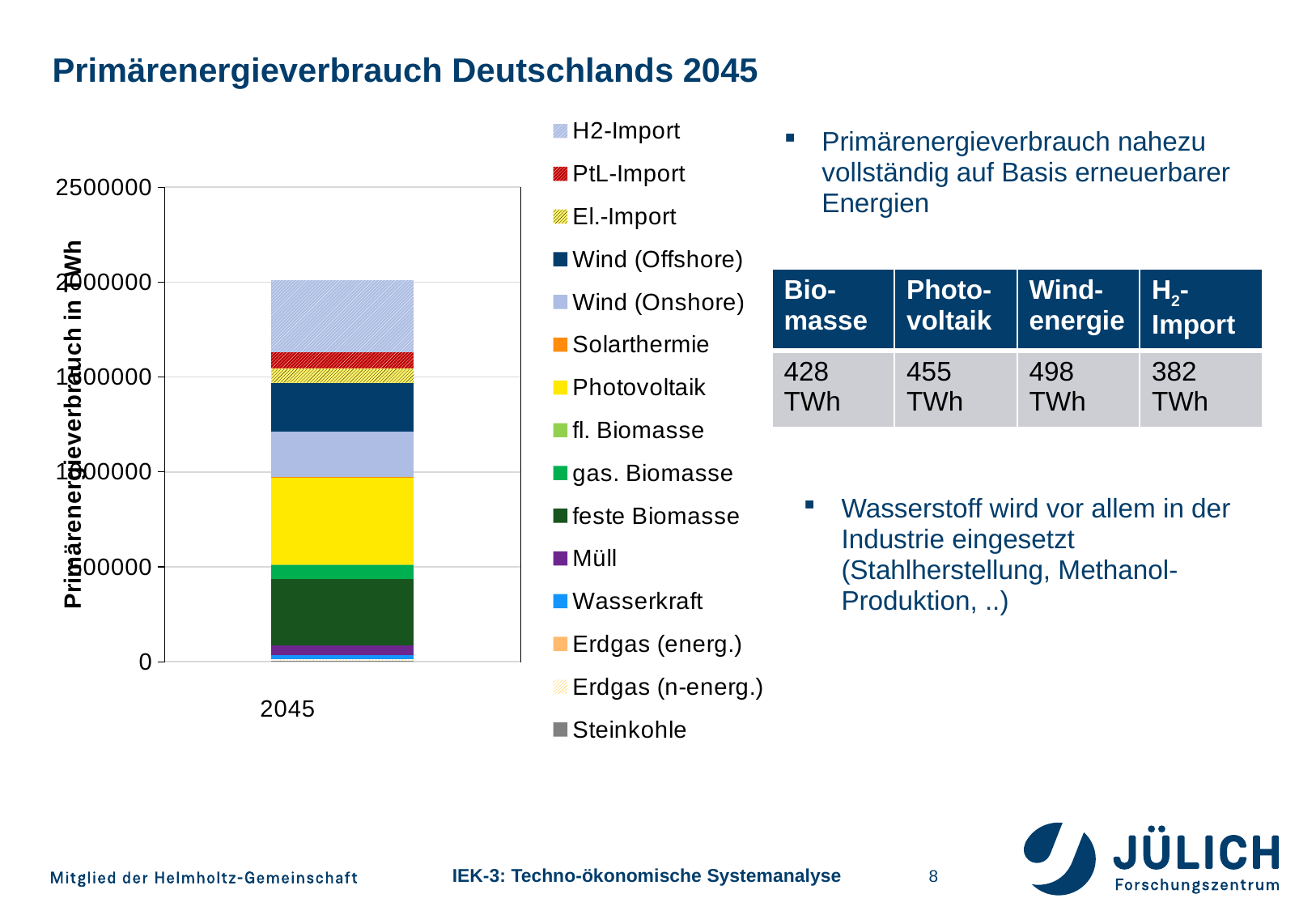
Which series is listed first in the chart's legend? H2-Import Which category label appears on the x axis of the chart? 2045 What kind of chart is shown on the slide? stacked bar chart In the 2045 bar, which segment is larger: Wind (Offshore) or Solarthermie? Wind (Offshore) How many categories are shown on the x axis of the chart? 1 What is the label of the y axis of the chart? Primärenergieverbrauch in TWh Is the total height of the stacked bar for 2045 greater or less than 1500000? greater In the 2045 bar, which segment is larger: feste Biomasse or Müll? feste Biomasse What is the highest value shown on the y axis of the chart? 2500000 In the 2045 bar, which segment is larger: Photovoltaik or Wind (Onshore)? Photovoltaik Is the total height of the stacked bar for 2045 greater or less than 2500000? less How many series does the chart's legend list? 15